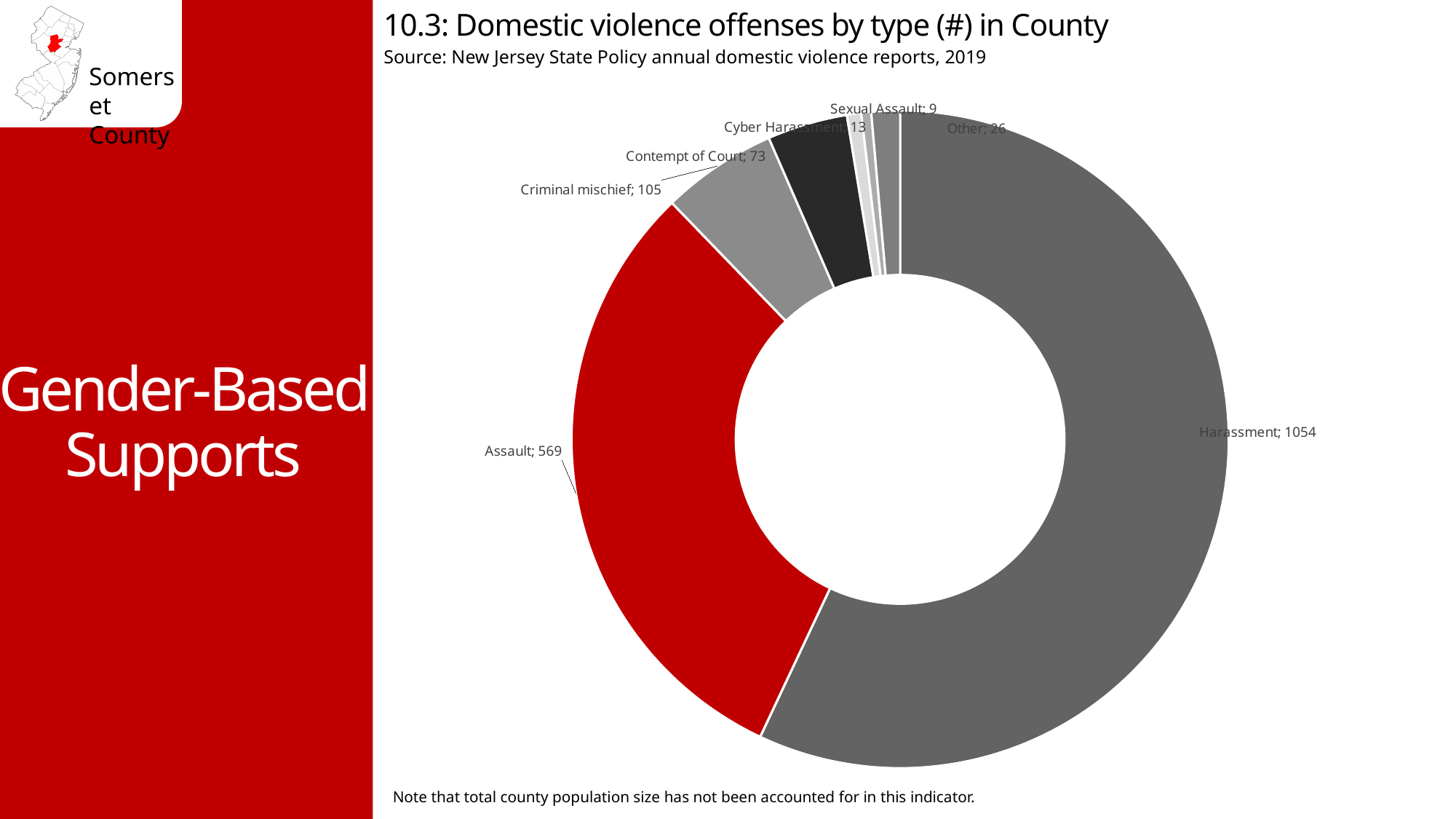
What value is shown for Contempt of Court? 73 How many offense types are shown on the chart? 7 What kind of chart is shown on the slide? doughnut chart How many domestic violence offenses of type Harassment are shown on the chart? 1054 What is the source cited for the chart? New Jersey State Policy annual domestic violence reports, 2019 What value is shown for Criminal mischief? 105 Which offense type has the largest number of offenses? Harassment What is the difference between the number of Harassment offenses and Assault offenses? 485 Which offense type has the smallest number of offenses? Sexual Assault Which is larger, the value for Cyber Harassment or the value for Other? Other What is the number of Assault offenses shown on the chart? 569 What value is shown for Sexual Assault? 9